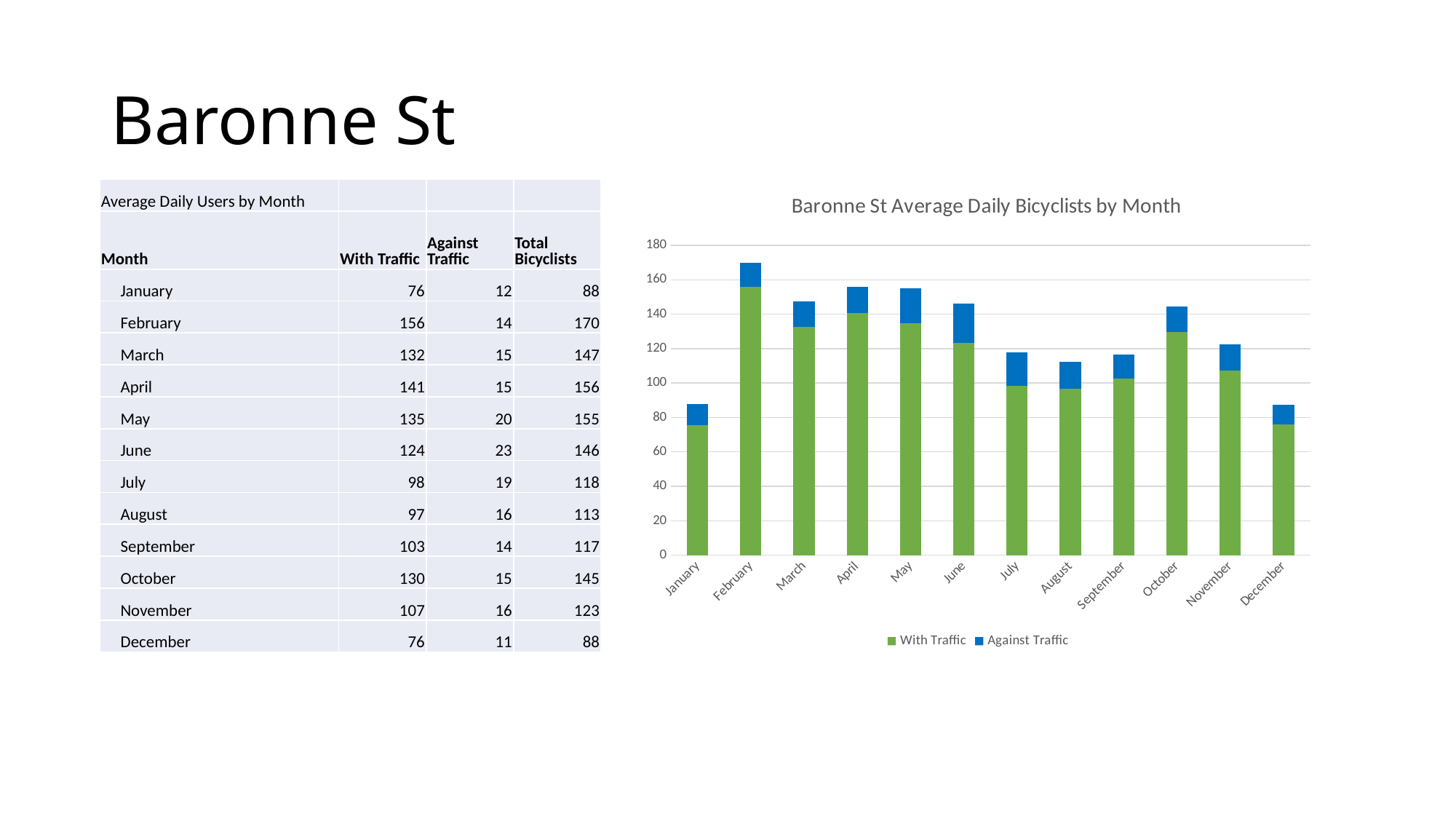
Which is larger, the total bar for March or the total bar for November? March Do the total bars rise or fall from February to August? fall What is the total height of the stacked bar for October? 145 What is the Against Traffic value for June? 23 How many months are plotted along the x axis of the chart? 12 What kind of chart is shown on the slide? stacked bar chart How many series does the chart legend list? 2 What is the With Traffic value for February? 156 Which series is shown in green in the chart? With Traffic Is the With Traffic value for April greater or less than 140? greater Which month has the tallest total bar in the chart? February Is the total bar for July greater or less than 120? less